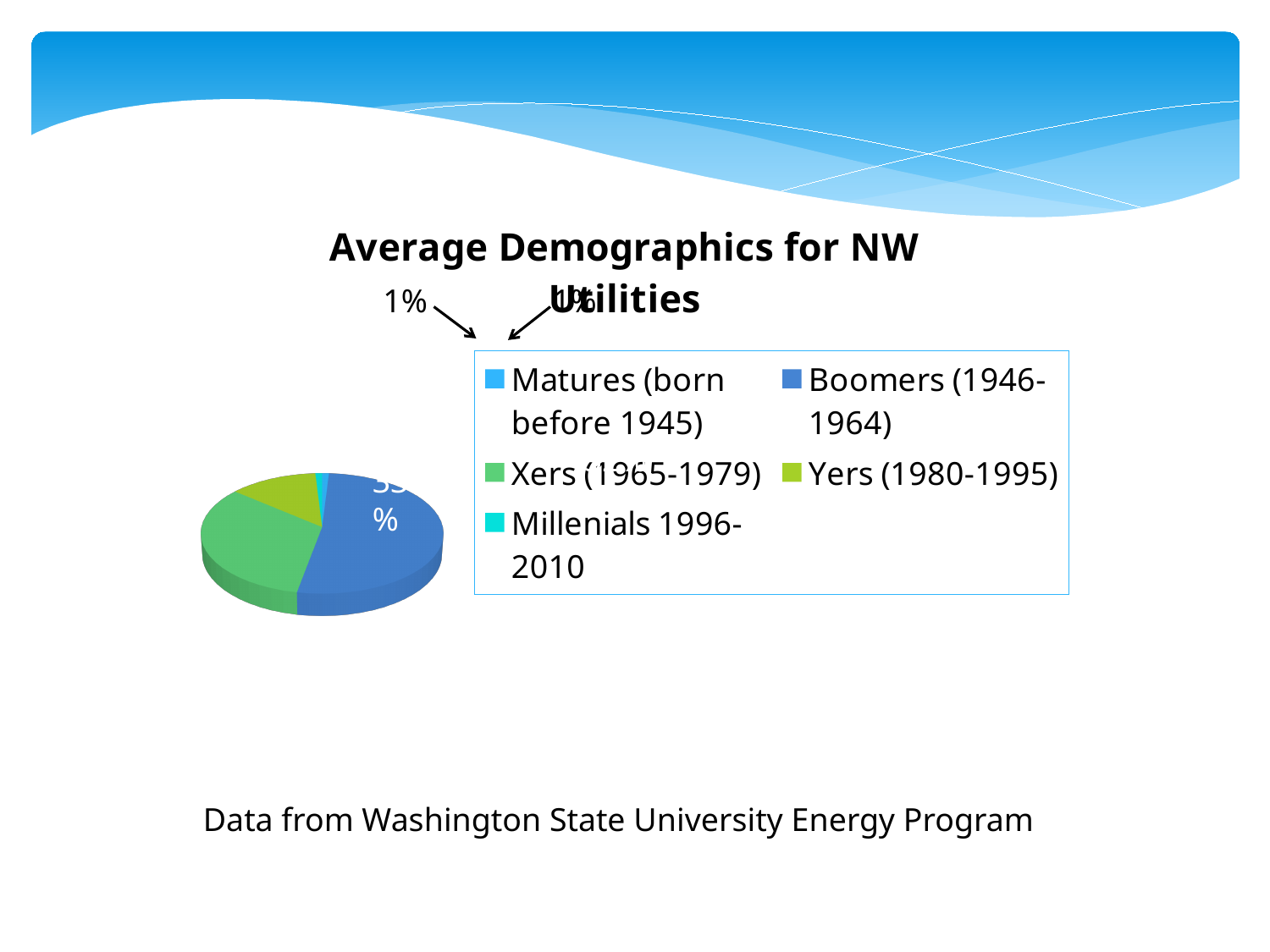
How many categories does the legend of the pie chart list? 5 Which category has the largest slice of the pie? Boomers (1946-1964) Is the share for Yers (1980-1995) greater or less than 25%? less Which slice is larger, Boomers (1946-1964) or Xers (1965-1979)? Boomers (1946-1964) Which slice is larger, Xers (1965-1979) or Yers (1980-1995)? Xers (1965-1979) Is the share for Xers (1965-1979) greater or less than 50%? less Which category is shown in the yellow-green colour in the legend? Yers (1980-1995) What kind of chart is shown on the slide? Pie chart What is the title of the chart? Average Demographics for NW Utilities What share of the pie is labelled for Millenials 1996-2010? 1% What share of the pie is labelled for Matures (born before 1945)? 1%